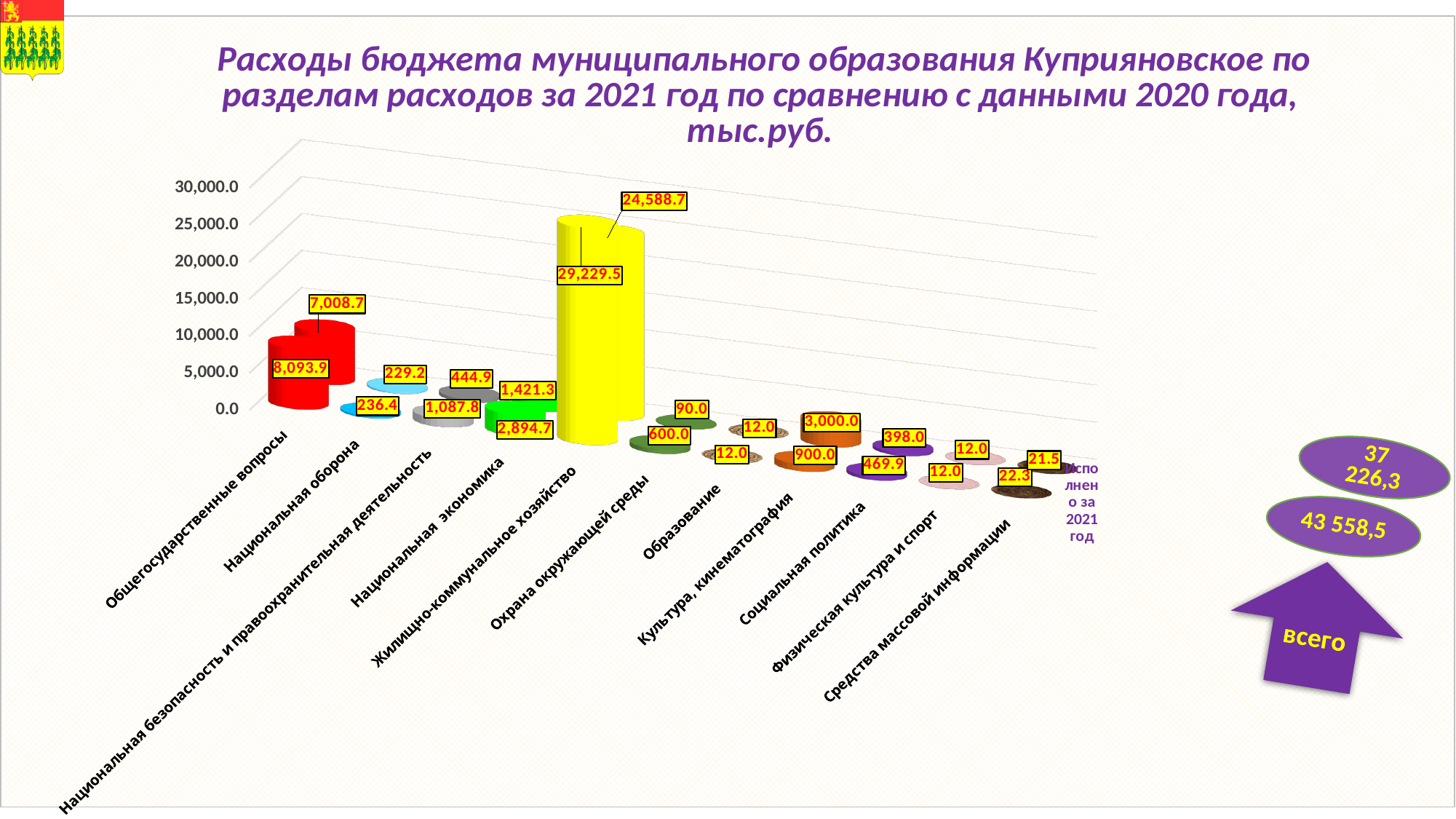
What kind of chart is shown on the slide? bar chart How many expenditure categories are shown along the x axis of the chart? 11 What is the front-row value labelled for Жилищно-коммунальное хозяйство? 29,229.5 Which category has the highest bars in the chart? Жилищно-коммунальное хозяйство What is the back-row value labelled for Образование? 12.0 Is the front-row value for Общегосударственные вопросы greater or less than 5,000.0? greater What is the back-row value labelled for Жилищно-коммунальное хозяйство? 24,588.7 What is the difference between the two values labelled for Жилищно-коммунальное хозяйство (29,229.5 and 24,588.7)? 4,640.8 For Культура, кинематография, which is larger: the front-row value or the back-row value? the back-row value (3,000.0) What is the front-row value labelled for Социальная политика? 469.9 What total value is shown in the oval that the 'всего' arrow points to? 43 558,5 What is the difference between the front-row value (8,093.9) and the back-row value (7,008.7) for Общегосударственные вопросы? 1,085.2